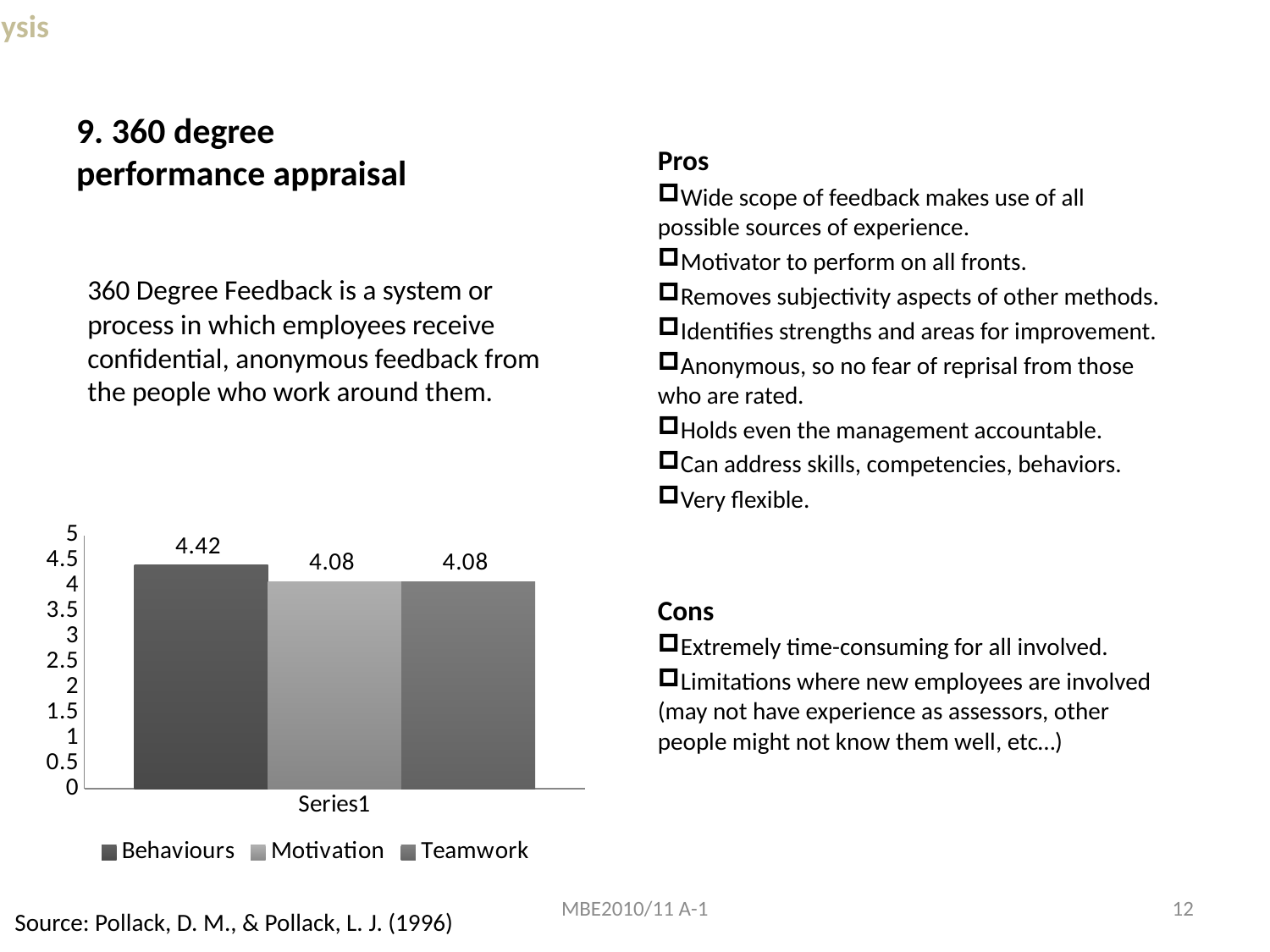
Is the value for Motivation greater or less than 3.5? greater What is the difference between the Behaviours value and the Motivation value? 0.34 What is the value for Behaviours in the bar chart? 4.42 What is the value for Motivation in the bar chart? 4.08 Which series has the highest value in the bar chart? Behaviours What is the category label shown on the x axis of the chart? Series1 What is the value for Teamwork in the bar chart? 4.08 Is the value for Behaviours greater or less than 4? greater Which is larger, the value for Behaviours or the value for Teamwork? Behaviours How many series does the legend of the chart list? 3 What kind of chart is shown on the slide? bar chart What are the three entries in the chart's legend? Behaviours, Motivation, Teamwork